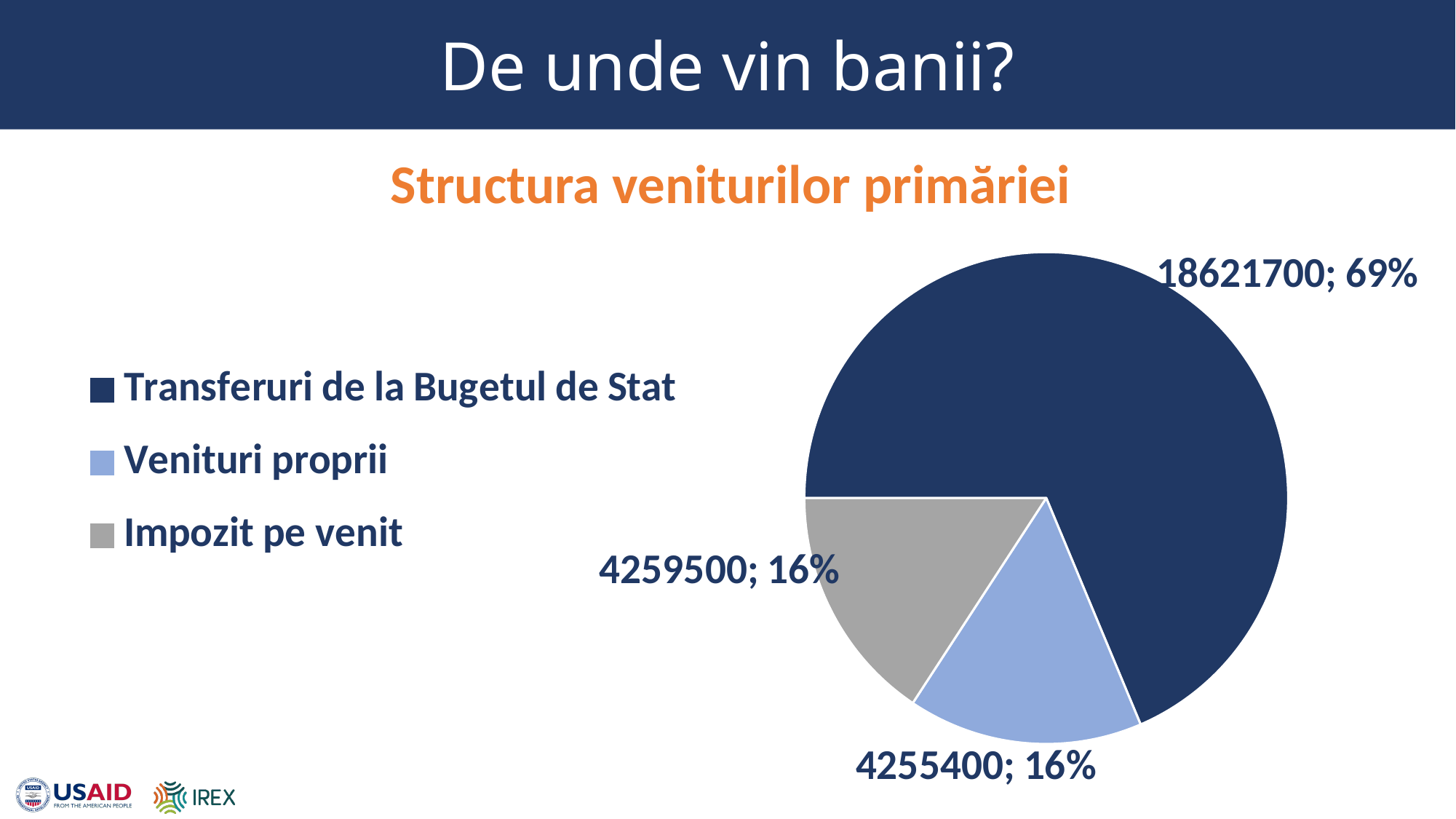
How many slices does the pie chart have? 3 What is the difference between the values for Impozit pe venit and Venituri proprii? 4100 What share of the pie does Impozit pe venit represent? 16% Which colour represents Impozit pe venit in the legend? gray What share of the pie does Transferuri de la Bugetul de Stat represent? 69% What value is shown for Impozit pe venit? 4259500 What is the title of the chart? Structura veniturilor primăriei What kind of chart is shown on the slide? pie chart Which category has the largest slice of the pie? Transferuri de la Bugetul de Stat What value is shown for Venituri proprii? 4255400 What value is shown for Transferuri de la Bugetul de Stat? 18621700 What is the difference between the values for Transferuri de la Bugetul de Stat and Venituri proprii? 14366300